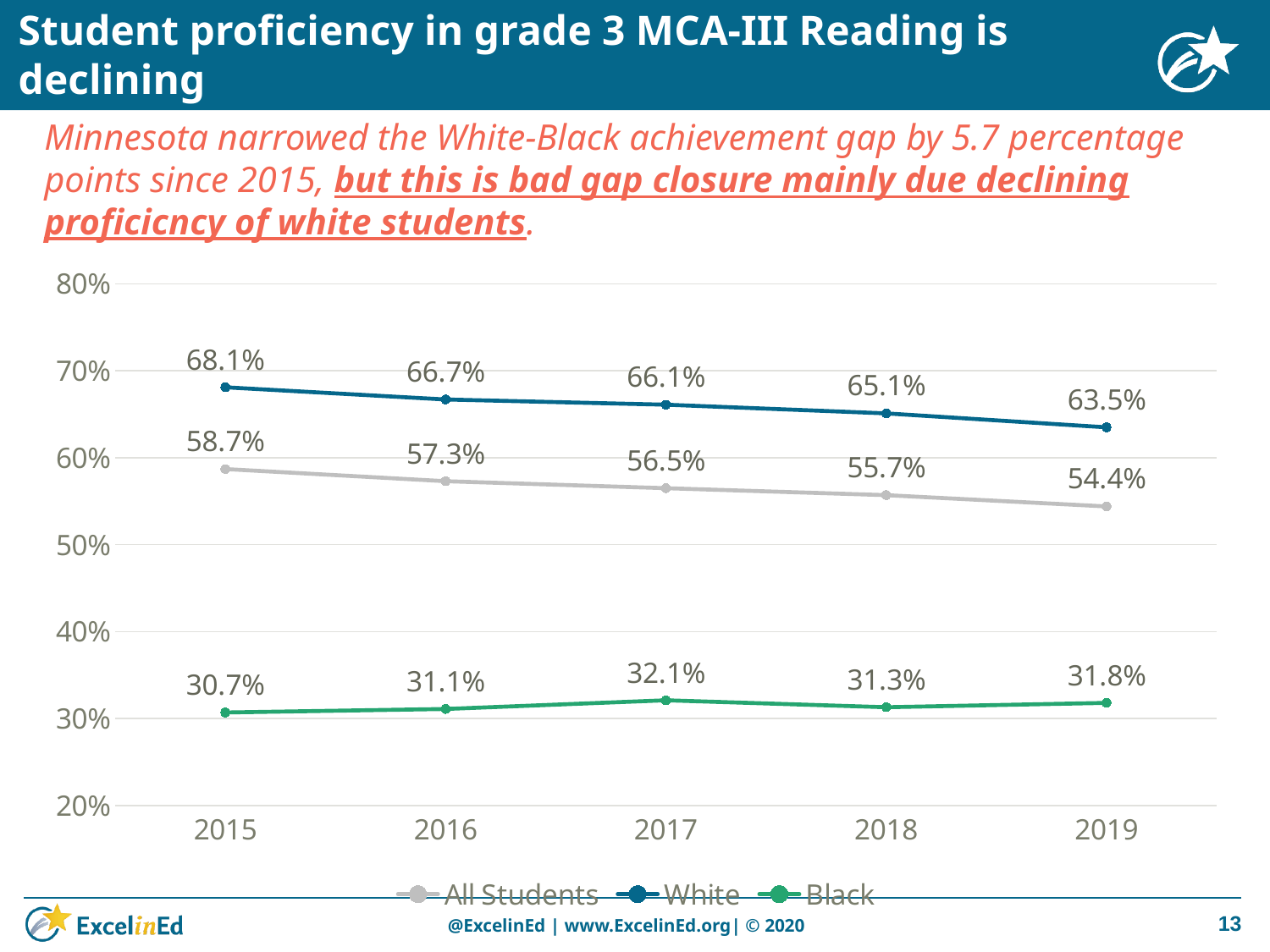
What kind of chart is shown on the slide? Line chart By how many percentage points did the White proficiency rate change from 2015 to 2019? 4.6 percentage points What was the proficiency rate for White students in 2015? 68.1% How many series does the legend list? 3 In which year was the proficiency rate for White students highest? 2015 What was the proficiency rate for All Students in 2019? 54.4% Which was higher in 2018: the proficiency rate for All Students or for Black students? All Students Does the proficiency rate for All Students rise or fall from 2015 to 2019? Fall What was the proficiency rate for Black students in 2017? 32.1% What is the difference between the White and Black proficiency rates in 2019? 31.7 percentage points In which year was the proficiency rate for Black students lowest? 2015 How many years are shown on the x axis? 5